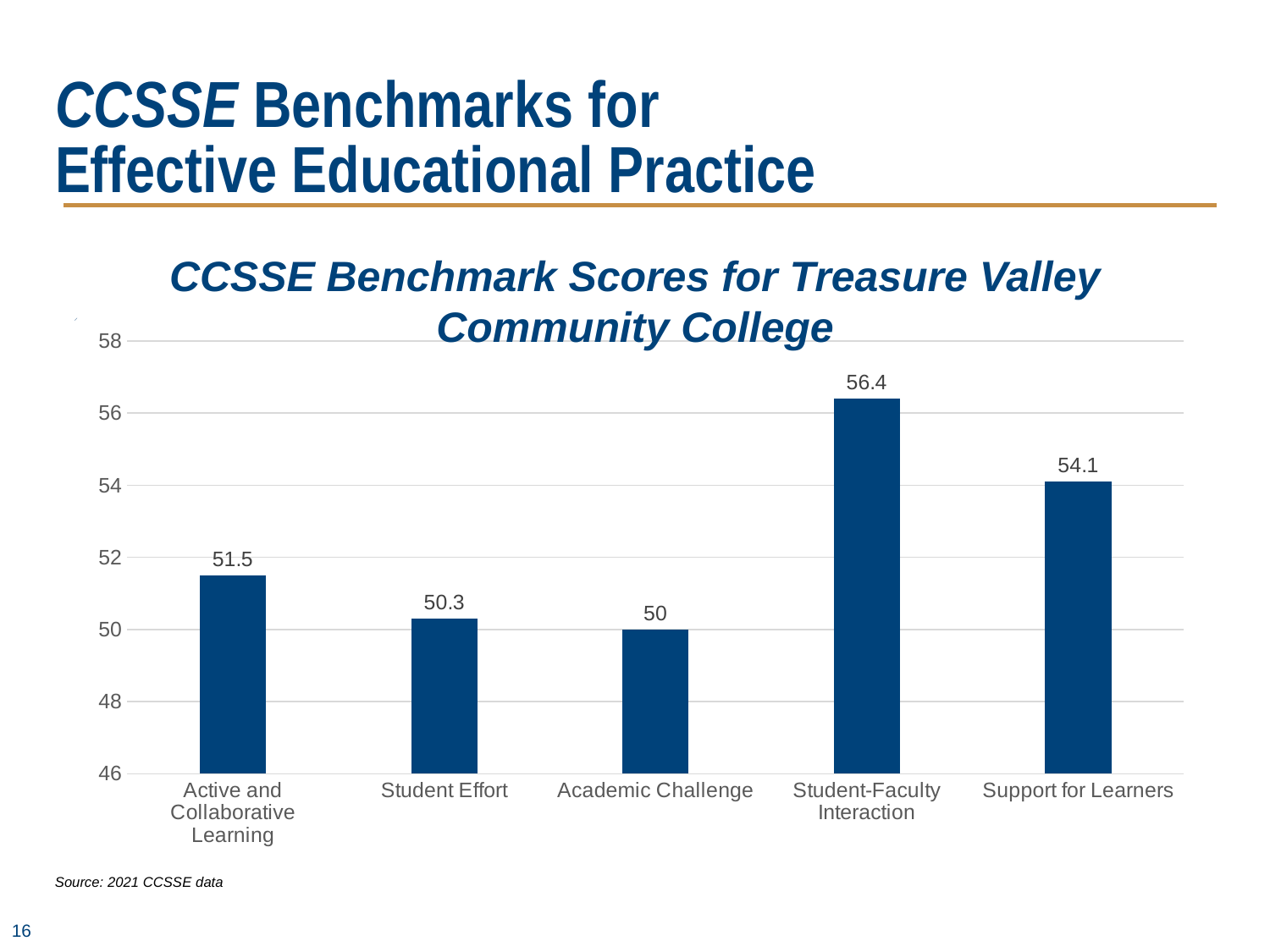
What is the CCSSE benchmark score for Active and Collaborative Learning? 51.5 What is the CCSSE benchmark score for Support for Learners? 54.1 Which benchmark has the highest score? Student-Faculty Interaction What is the title of the chart? CCSSE Benchmark Scores for Treasure Valley Community College What is the difference between the Student-Faculty Interaction score and the Support for Learners score? 2.3 What is the CCSSE benchmark score for Academic Challenge? 50 What is the difference between the Active and Collaborative Learning score and the Student Effort score? 1.2 Which benchmark has the lowest score? Academic Challenge What kind of chart is shown on the slide? Bar chart Which has a higher score, Student Effort or Support for Learners? Support for Learners What is the CCSSE benchmark score for Student-Faculty Interaction? 56.4 How many benchmarks are shown in the chart? 5